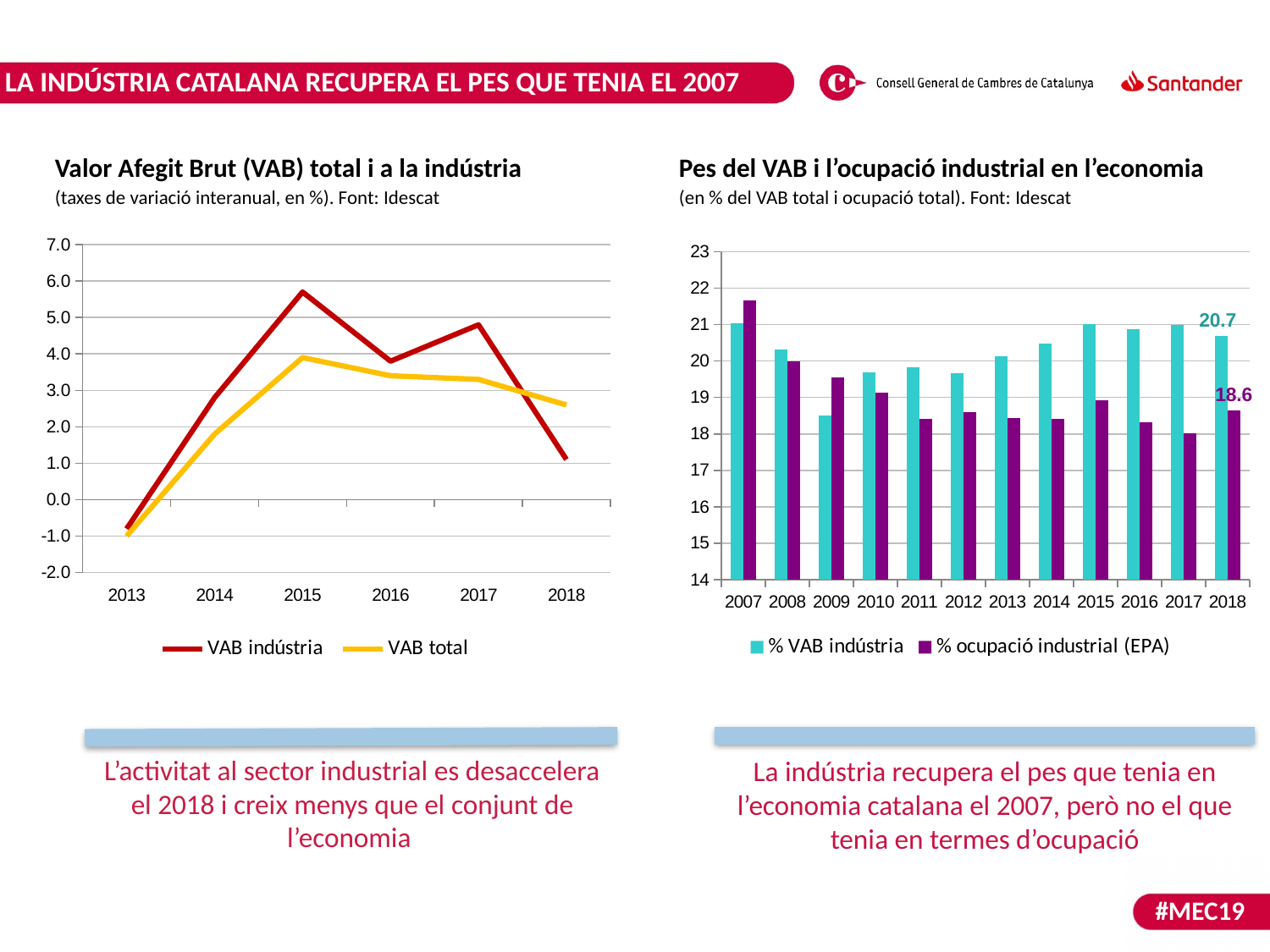
What kind of chart is the left chart, 'Valor Afegit Brut (VAB) total i a la indústria'? line chart In the right chart, 'Pes del VAB i l'ocupació industrial en l'economia', what is the value of % ocupació industrial (EPA) for 2018? 18.6 In the left chart, 'Valor Afegit Brut (VAB) total i a la indústria', in which year is VAB indústria highest? 2015 In the right chart, 'Pes del VAB i l'ocupació industrial en l'economia', what is the difference between % VAB indústria and % ocupació industrial (EPA) in 2018? 2.1 How many years are shown on the x axis of the right chart, 'Pes del VAB i l'ocupació industrial en l'economia'? 12 In the left chart, 'Valor Afegit Brut (VAB) total i a la indústria', which series has the larger value in 2018, VAB indústria or VAB total? VAB total In the left chart, 'Valor Afegit Brut (VAB) total i a la indústria', in which year is VAB indústria lowest? 2013 In the left chart, 'Valor Afegit Brut (VAB) total i a la indústria', is the value of VAB indústria in 2015 greater or less than 5.0? greater In the right chart, 'Pes del VAB i l'ocupació industrial en l'economia', what is the value of % VAB indústria for 2018? 20.7 What kind of chart is the right chart, 'Pes del VAB i l'ocupació industrial en l'economia'? bar chart In the left chart, 'Valor Afegit Brut (VAB) total i a la indústria', does VAB indústria rise or fall from 2017 to 2018? fall In the right chart, 'Pes del VAB i l'ocupació industrial en l'economia', in which year is % ocupació industrial (EPA) highest? 2007